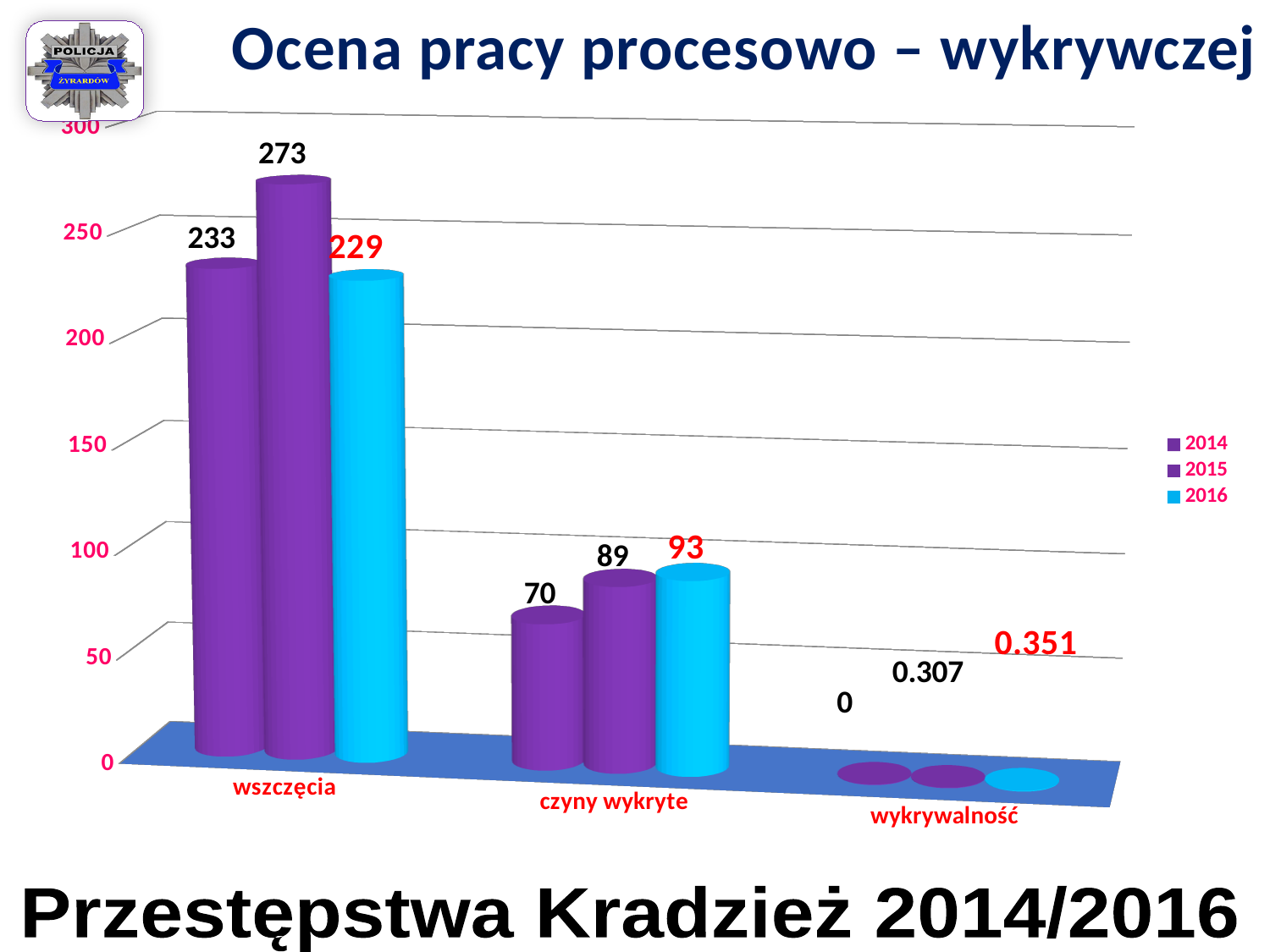
What is the difference between the 2016 and 2015 values in the czyny wykryte category? 4 Which year has the highest value in the wszczęcia category? 2015 What is the value for 2015 in the wykrywalność category? 0.307 What is the difference between the 2015 and 2014 values in the wszczęcia category? 40 Which year has the lowest value in the czyny wykryte category? 2014 What is the value for 2016 in the czyny wykryte category? 93 How many categories are shown on the x axis? 3 What is the value for 2014 in the wykrywalność category? 0 What kind of chart is shown on the slide? bar chart Which is larger in the wszczęcia category: the 2014 value or the 2016 value? 2014 How many series does the legend list? 3 What is the value for 2015 in the wszczęcia category? 273